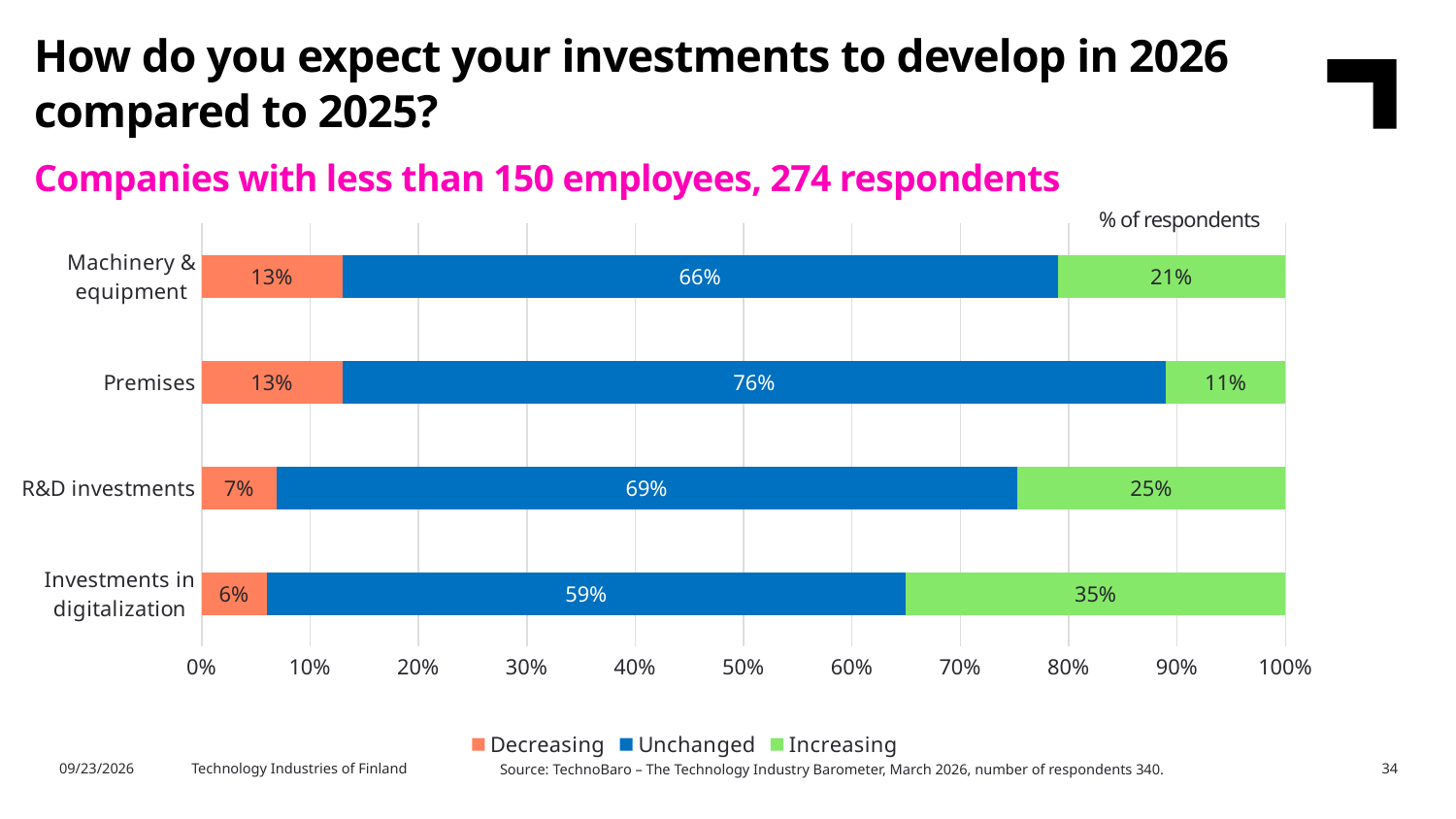
How many investment categories are shown in the chart? 4 What is the difference between the Increasing share for R&D investments and the Increasing share for Premises? 14% Which series is shown in green in the legend? Increasing Which is larger: the Unchanged share for Premises or the Unchanged share for R&D investments? Premises What percentage of respondents expect R&D investments to be Decreasing? 7% What kind of chart is shown on the slide? Stacked bar chart What percentage of respondents expect Machinery & equipment investments to be Unchanged? 66% What percentage of respondents expect Investments in digitalization to be Increasing? 35% How many series does the legend list? 3 What percentage of respondents expect Premises investments to be Increasing? 11% Which category has the lowest share of respondents expecting Unchanged investments? Investments in digitalization Which category has the highest share of respondents expecting Increasing investments? Investments in digitalization